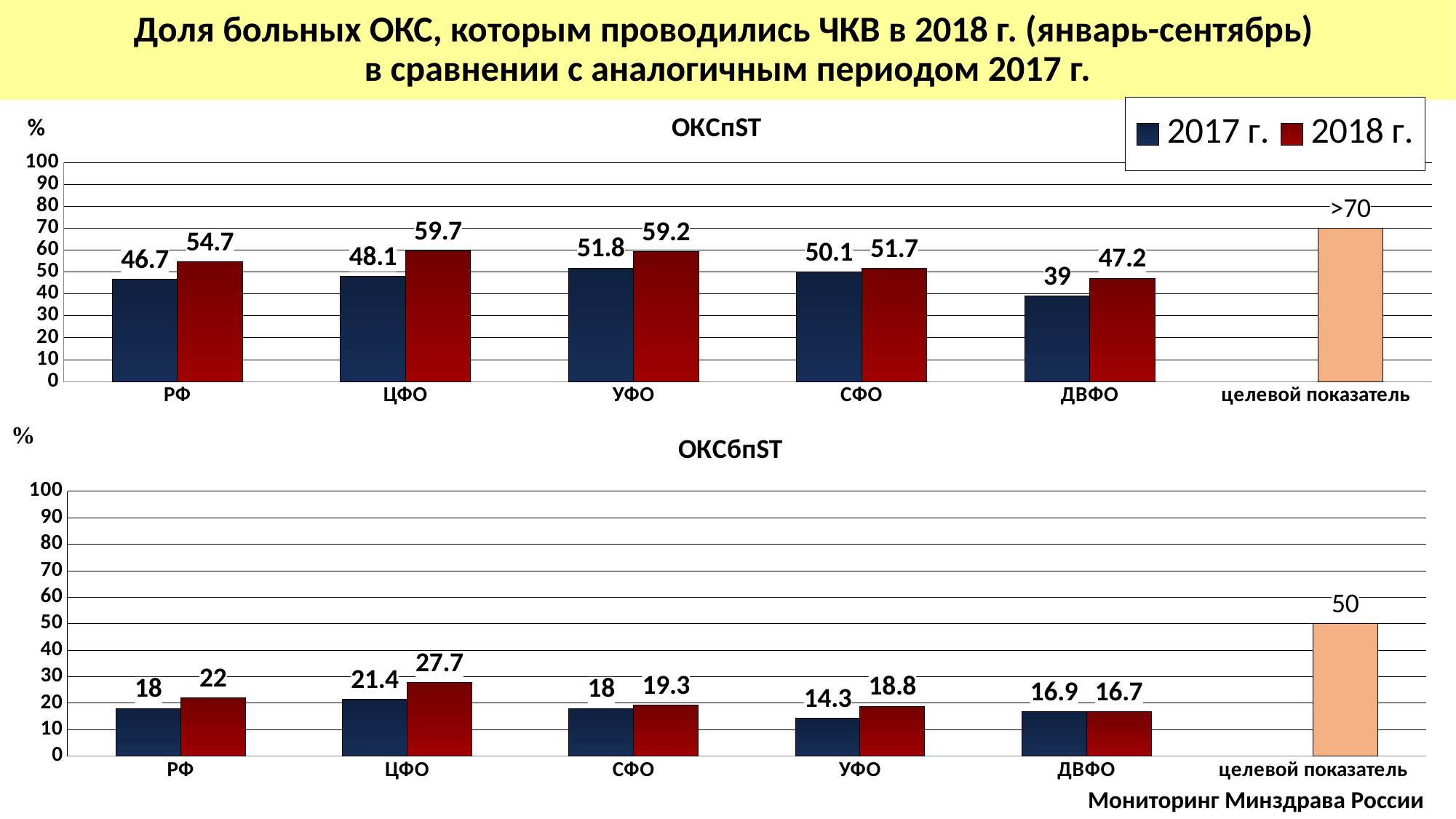
What type of chart is the ОКСпST chart? bar chart In the ОКСбпST chart, what is the difference between the 2018 г. and 2017 г. values for ЦФО? 6.3 In the ОКСпST chart, what is the difference between the 2018 г. and 2017 г. values for РФ? 8 In the ОКСпST chart, which region has the highest 2018 г. value? ЦФО In the ОКСпST chart, what is the value for ДВФО in 2017 г.? 39 In the ОКСбпST chart, which region has the highest 2018 г. value? ЦФО In the ОКСбпST chart, what is the value for УФО in 2017 г.? 14.3 In the ОКСпST chart, which region has the lowest 2017 г. value? ДВФО How many series does the legend list? 2 In the ОКСбпST chart, what is the value of the целевой показатель bar? 50 In the ОКСбпST chart, which is larger for ДВФО: the 2017 г. value or the 2018 г. value? 2017 г. In the ОКСпST chart, what is the value for ЦФО in 2018 г.? 59.7